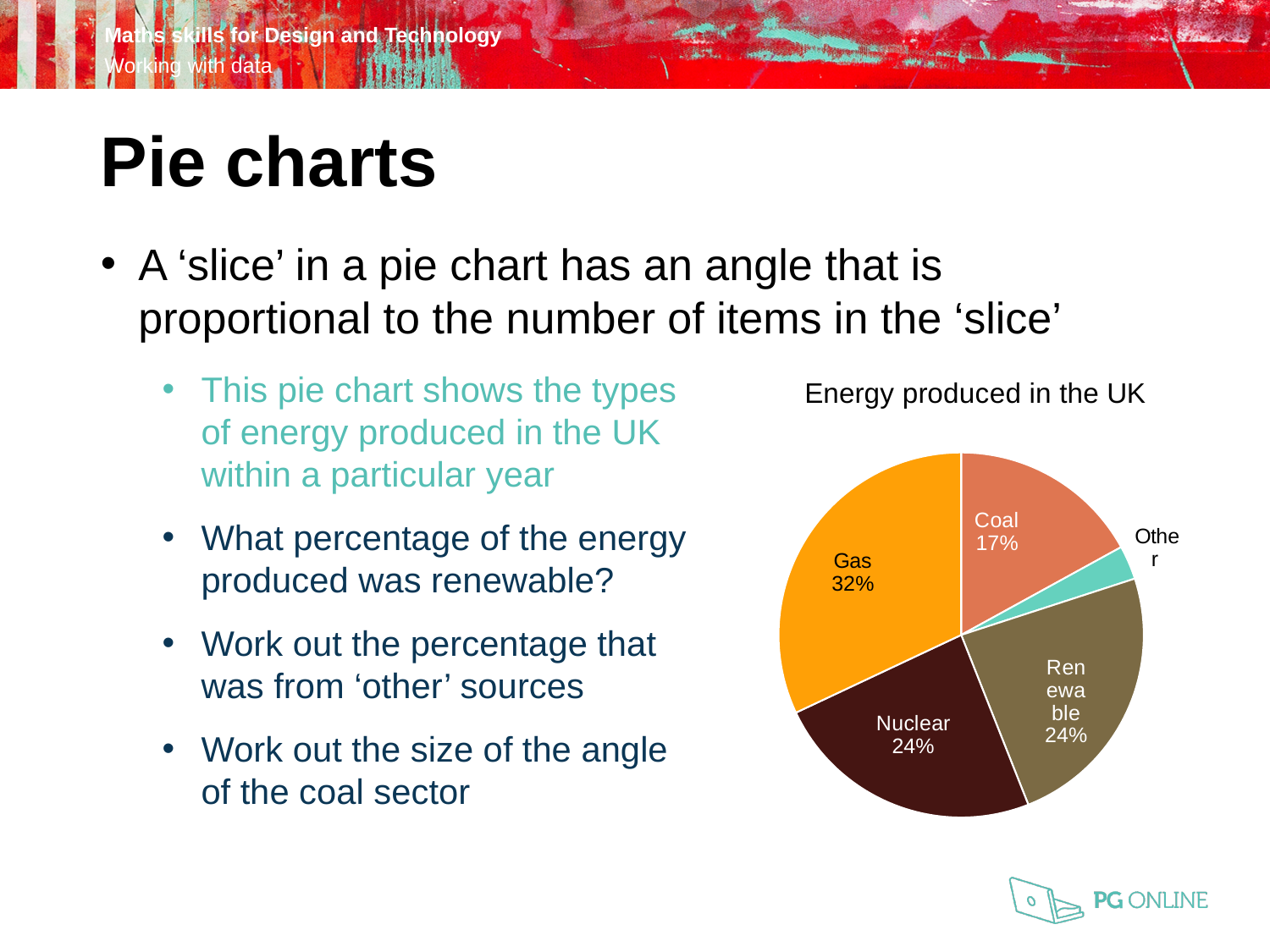
What percentage of the pie chart is Coal? 17% What percentage of the pie chart is Gas? 32% What percentage of the pie chart is Renewable? 24% What is the title of the chart? Energy produced in the UK What is the difference in percentage points between the Gas slice and the Nuclear slice? 8% What is the difference in percentage points between the Gas slice and the Coal slice? 15% What type of chart is shown on the slide? Pie chart What percentage of the pie chart is Nuclear? 24% Which energy type has the largest slice of the pie chart? Gas How many slices does the pie chart have? 5 Which energy type has the smallest slice of the pie chart? Other Which slice is larger, Gas or Coal? Gas